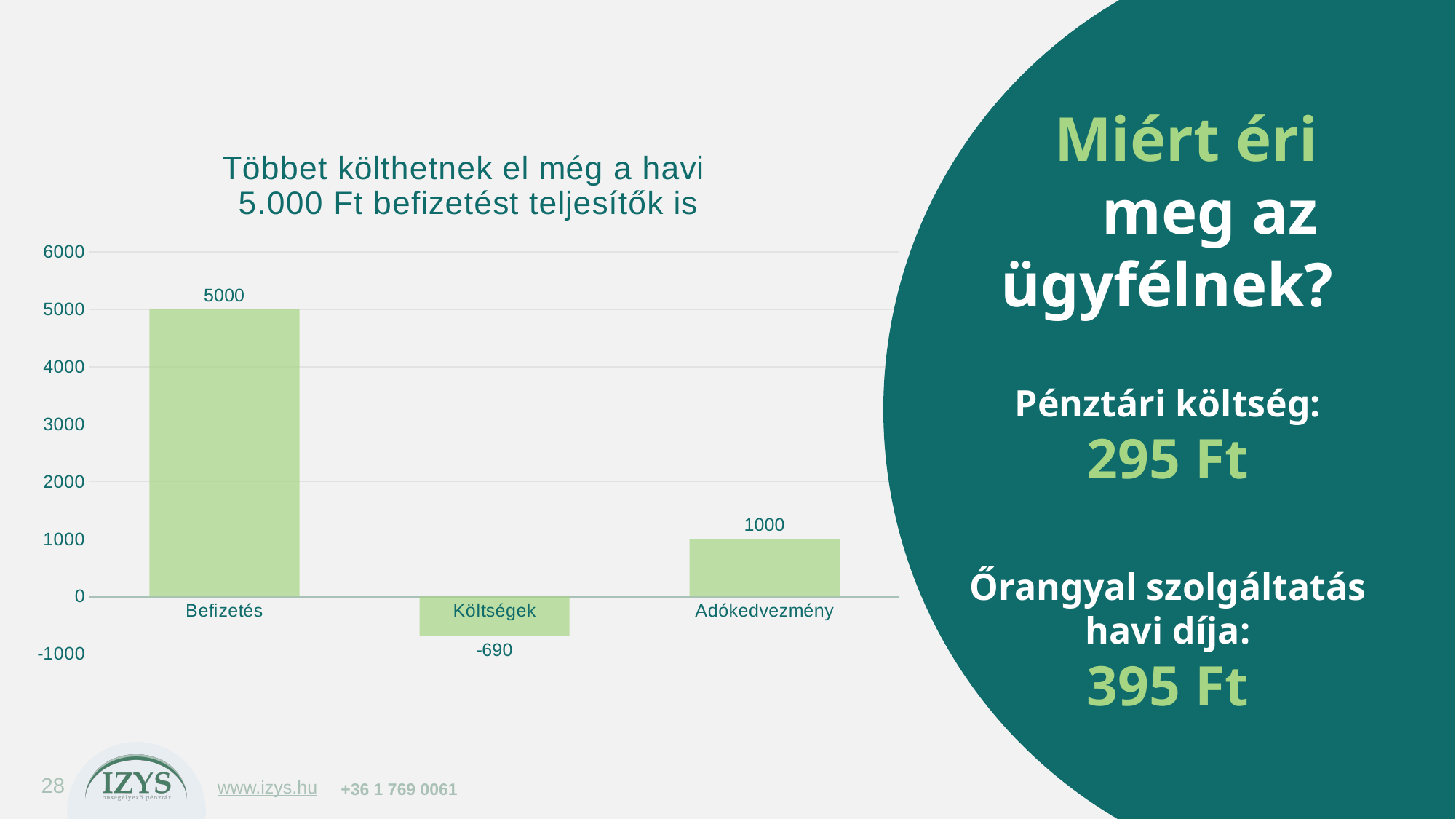
How many categories are shown on the x axis? 3 What kind of chart is shown on the slide? bar chart What is the value for Adókedvezmény? 1000 What is the value for Költségek? -690 Which is larger, the value for Adókedvezmény or the value for Költségek? Adókedvezmény Which category has the lowest value? Költségek Which category has the highest value? Befizetés What is the title of the chart? Többet költhetnek el még a havi 5.000 Ft befizetést teljesítők is Is the value for Befizetés greater or less than 4000? greater What is the value for Befizetés? 5000 Which category has a negative value? Költségek What is the difference between the values for Befizetés and Adókedvezmény? 4000